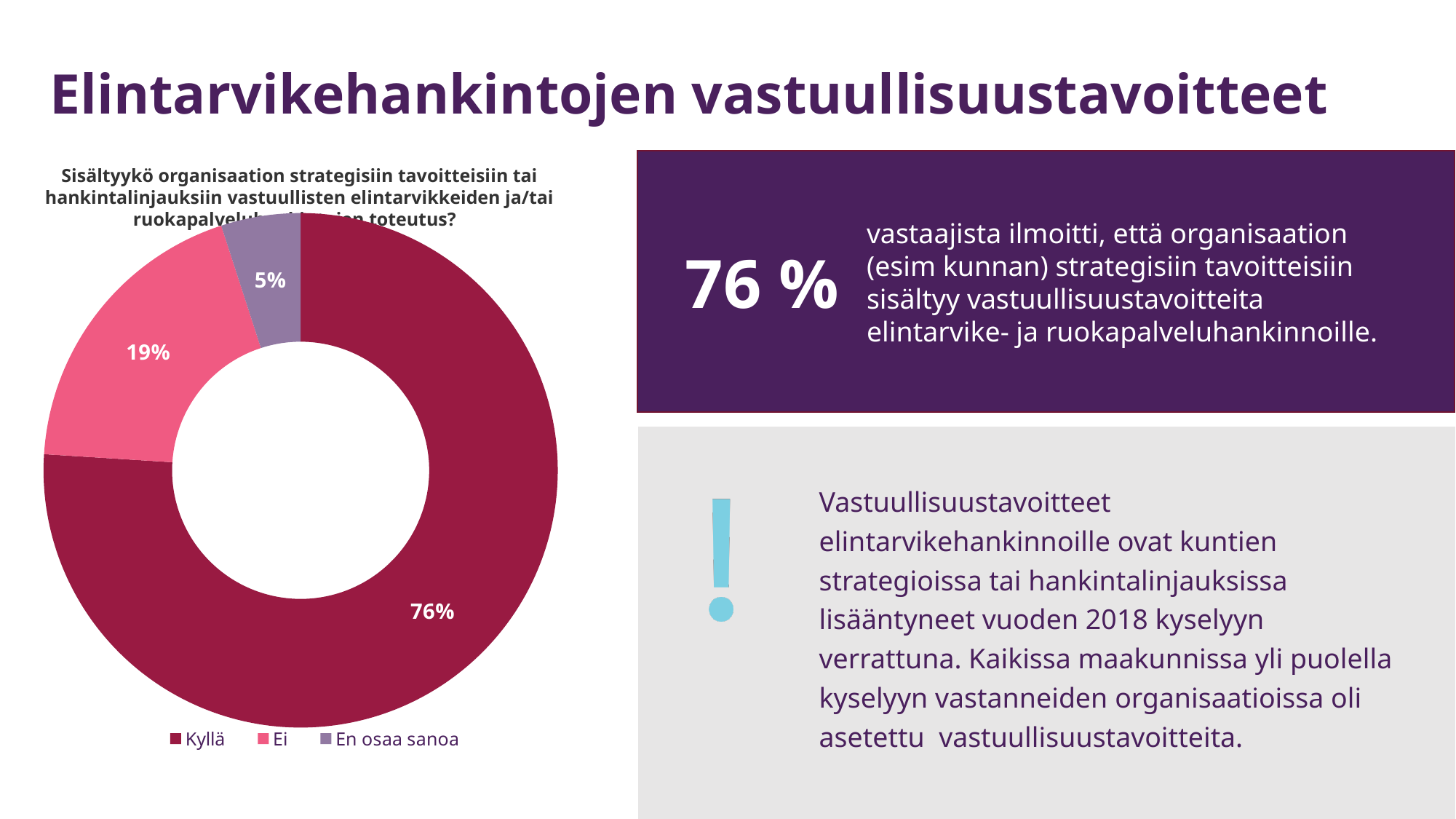
Which legend entry is listed first in the pie chart's legend? Kyllä What is the difference in percentage points between the "Ei" and "En osaa sanoa" shares? 14 What share of the pie chart is labelled "Ei"? 19% What colour is the "Ei" slice in the pie chart? Pink What share of the pie chart is labelled "En osaa sanoa"? 5% Which category has the largest share in the pie chart? Kyllä What is the difference in percentage points between the "Kyllä" and "Ei" shares? 57 Which category has the smallest share in the pie chart? En osaa sanoa What kind of chart is shown on the slide? Doughnut chart Which is larger, the share for "Ei" or the share for "En osaa sanoa"? Ei How many categories does the pie chart show? 3 What share of the pie chart is labelled "Kyllä"? 76%